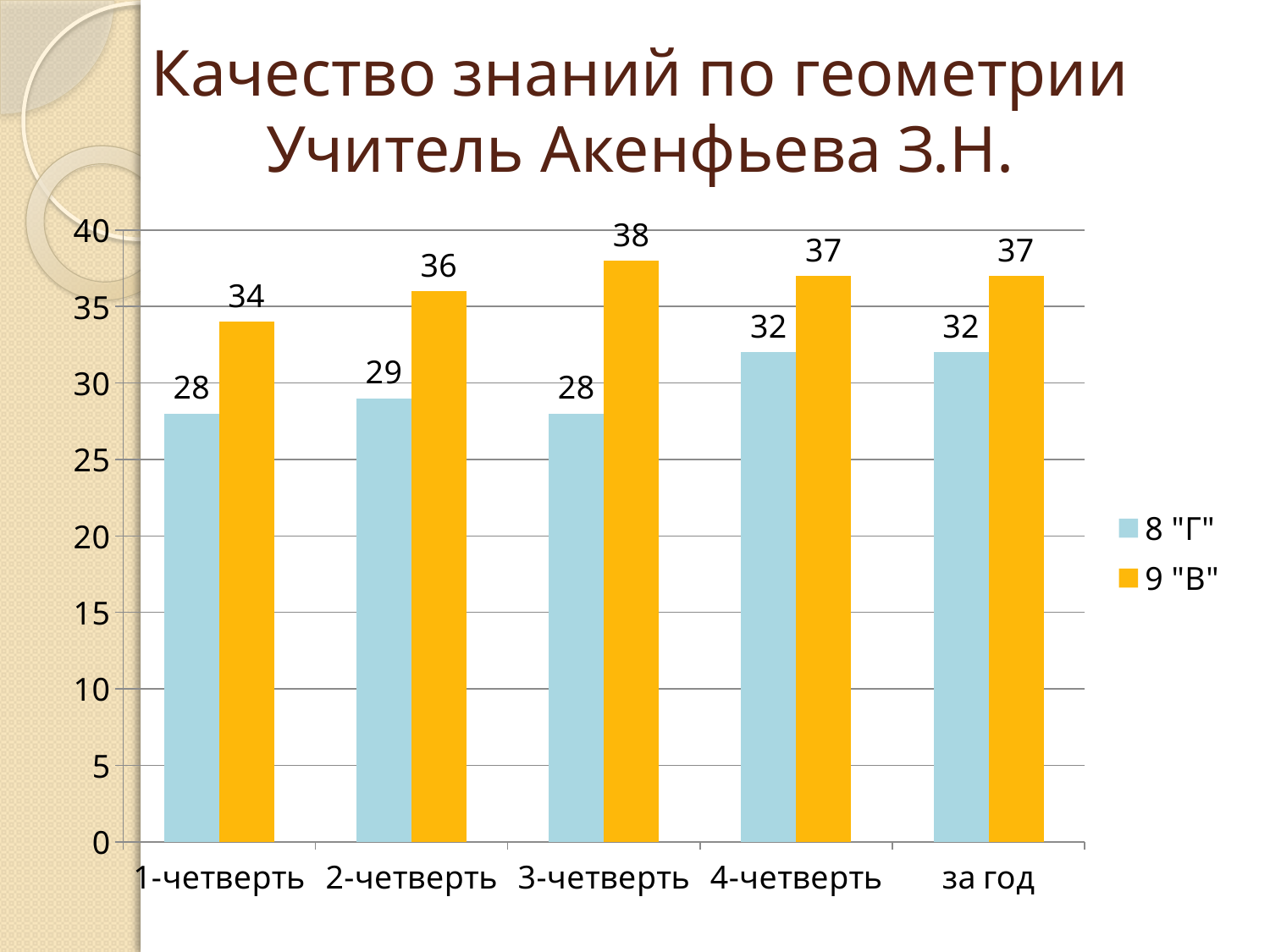
What is the difference between 9 "В" and 8 "Г" in 2-четверть? 7 Which is larger in 4-четверть: 8 "Г" or 9 "В"? 9 "В" What is the value for 9 "В" in 3-четверть? 38 What kind of chart is shown on the slide? bar chart What is the value for 8 "Г" in 1-четверть? 28 In which category is the value for 9 "В" highest? 3-четверть How many categories are shown on the x axis? 5 Does the value for 9 "В" rise or fall from 1-четверть to 3-четверть? rise Which colour represents the 9 "В" series? orange How many series does the legend list? 2 In which category is the value for 9 "В" lowest? 1-четверть What is the value for 8 "Г" за год? 32